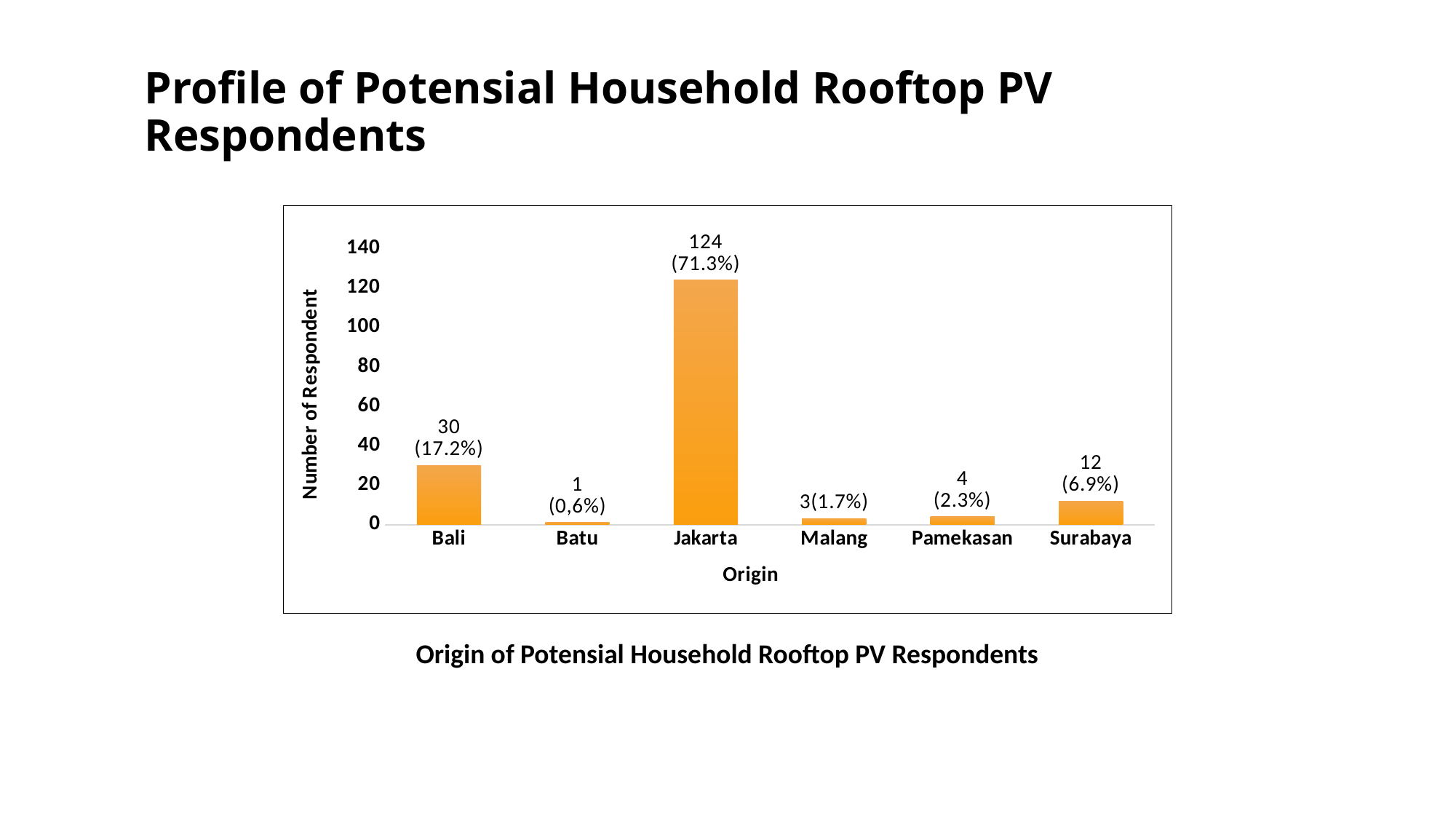
How many respondents are from Jakarta? 124 Which origin has the lowest number of respondents? Batu How many respondents are from Pamekasan? 4 Which has more respondents, Surabaya or Malang? Surabaya Which origin has the highest number of respondents? Jakarta What kind of chart is shown on the slide? Bar chart What percentage of respondents are from Surabaya? 6.9% What is the difference in number of respondents between Jakarta and Bali? 94 How many origin categories are shown on the x axis? 6 What is the label of the y axis? Number of Respondent How many respondents are from Bali? 30 Is the value for Jakarta greater or less than 100? greater